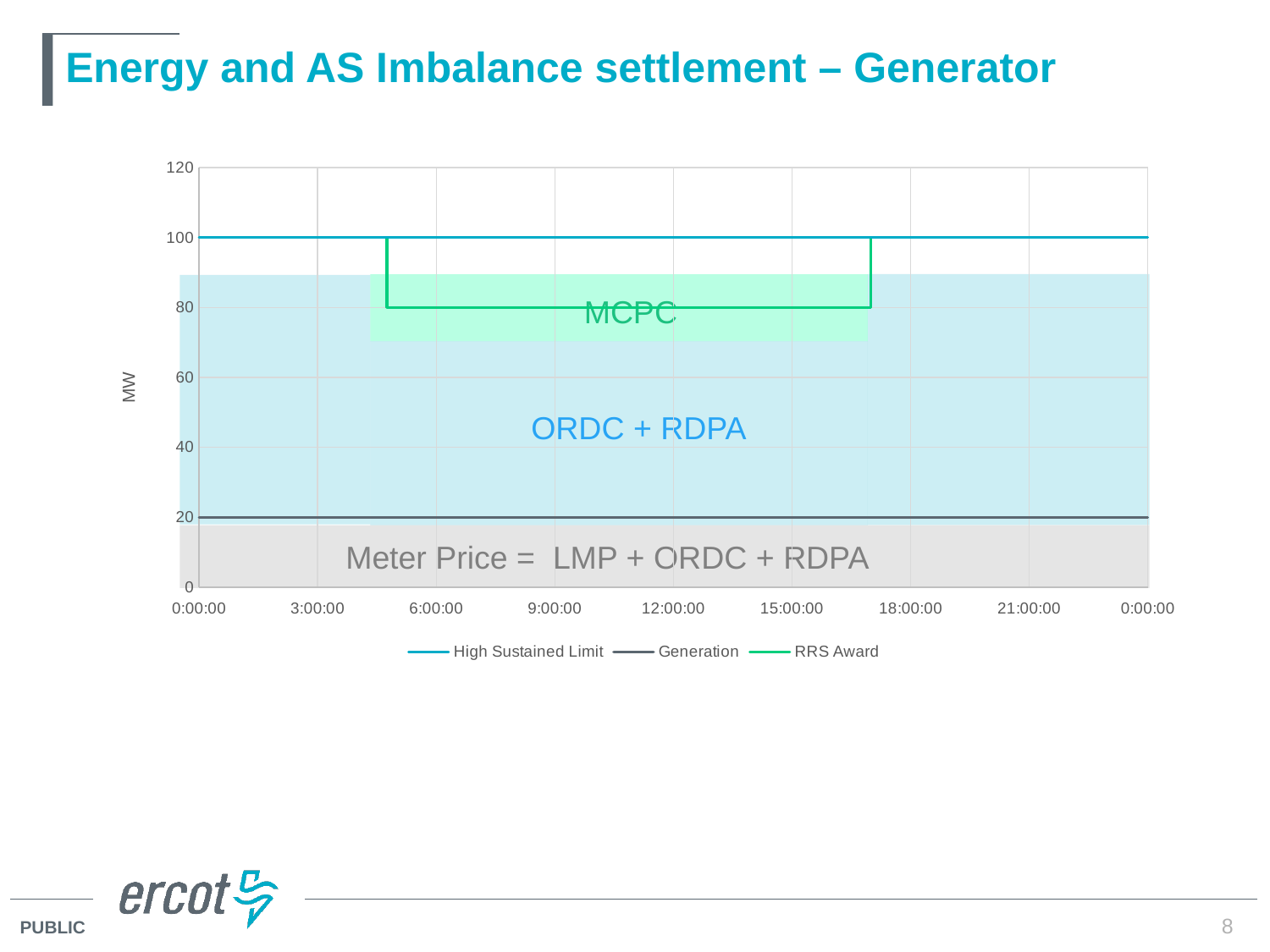
What text is written inside the grey shaded area at the bottom of the chart? Meter Price = LMP + ORDC + RDPA Which series has the lowest value across the whole chart? Generation What is the value of the High Sustained Limit series in MW? 100 What is the value of the Generation series in MW? 20 What kind of chart is shown on the slide? line chart What label is shown on the y axis? MW How many series does the legend list? 3 Is the value for Generation greater or less than 40? less Which is larger at 12:00:00, the High Sustained Limit or the RRS Award? High Sustained Limit What is the difference between the High Sustained Limit and the Generation value in MW? 80 What is the value of the RRS Award series at 12:00:00 in MW? 80